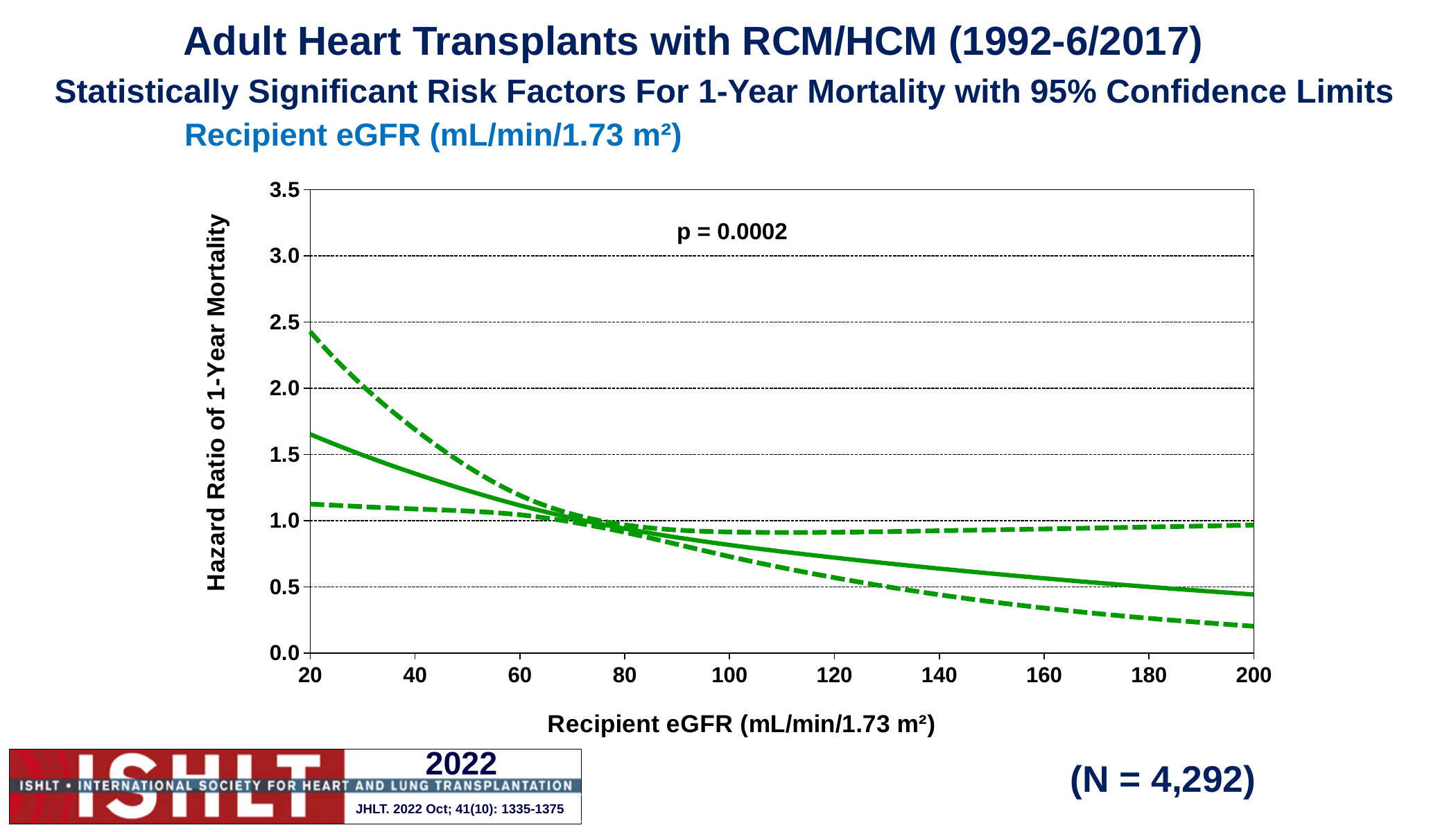
Is the hazard ratio on the solid line at a recipient eGFR of 20 greater or less than 1.5? greater Is the lower dashed confidence limit at a recipient eGFR of 200 greater or less than 0.5? less What is the highest value shown on the x-axis? 200 Is the hazard ratio on the solid line at a recipient eGFR of 100 greater or less than 1.0? less What is the label of the y-axis? Hazard Ratio of 1-Year Mortality Does the solid hazard ratio line rise or fall as recipient eGFR increases from 20 to 200? Fall How many lines are plotted on the chart? 3 What is the highest value shown on the y-axis? 3.5 What kind of chart is shown on the slide? Line chart What is the p-value printed on the chart? p = 0.0002